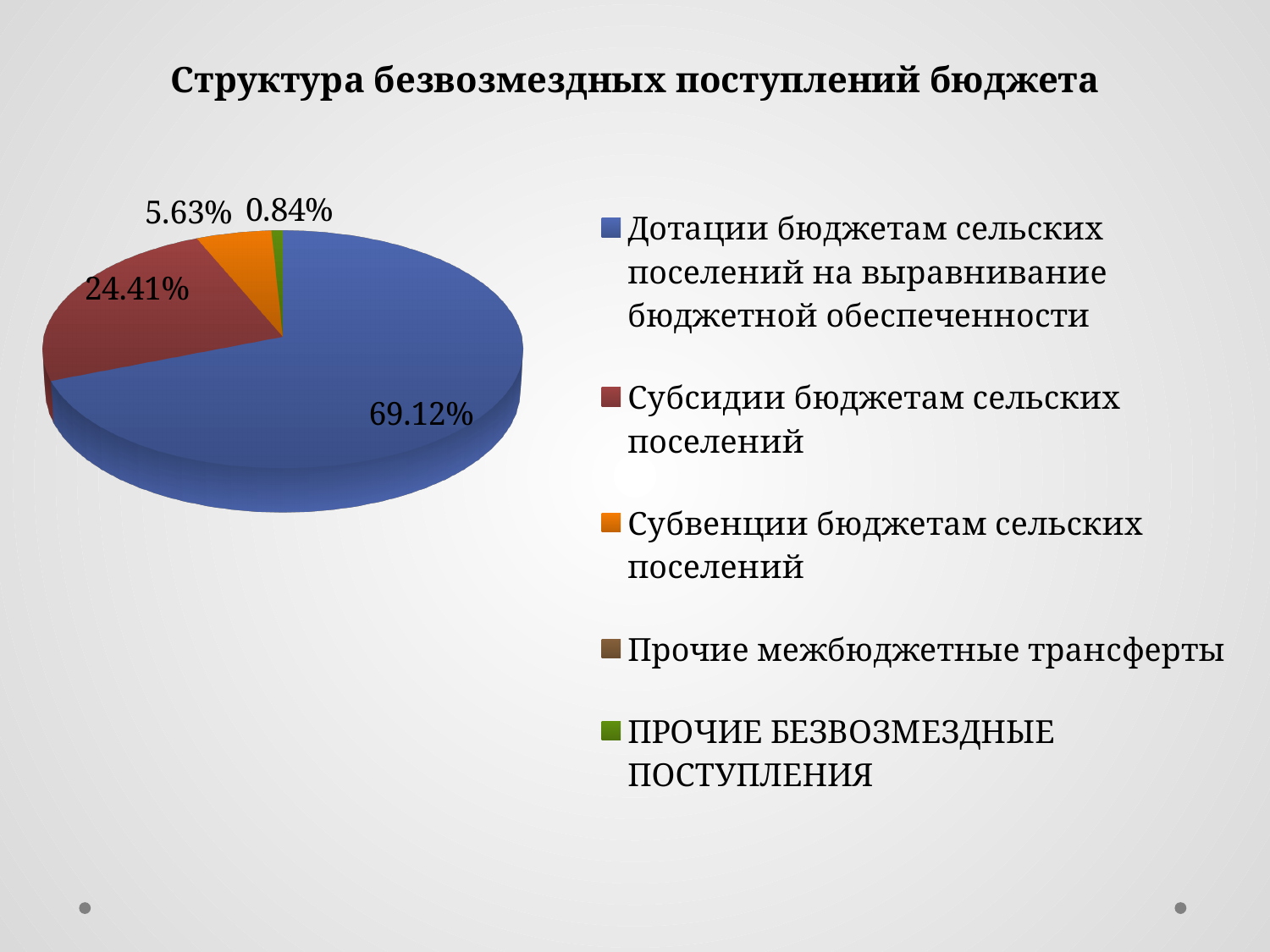
How many entries does the legend list? 5 Which labelled category has the smallest share of the pie? ПРОЧИЕ БЕЗВОЗМЕЗДНЫЕ ПОСТУПЛЕНИЯ What share of the pie is labelled for 'Субсидии бюджетам сельских поселений'? 24.41% What share of the pie is labelled for 'Дотации бюджетам сельских поселений на выравнивание бюджетной обеспеченности'? 69.12% What share of the pie is labelled for 'Субвенции бюджетам сельских поселений'? 5.63% Which category has the largest share of the pie? Дотации бюджетам сельских поселений на выравнивание бюджетной обеспеченности What is the title of the chart? Структура безвозмездных поступлений бюджета What colour is the slice for 'Субсидии бюджетам сельских поселений'? Red What share of the pie is labelled for 'ПРОЧИЕ БЕЗВОЗМЕЗДНЫЕ ПОСТУПЛЕНИЯ'? 0.84% Which is larger: the share for 'Субвенции бюджетам сельских поселений' or the share for 'ПРОЧИЕ БЕЗВОЗМЕЗДНЫЕ ПОСТУПЛЕНИЯ'? Субвенции бюджетам сельских поселений What is the difference in percentage points between the shares for 'Дотации бюджетам сельских поселений на выравнивание бюджетной обеспеченности' and 'Субсидии бюджетам сельских поселений'? 44.71% What type of chart is shown on the slide? Pie chart